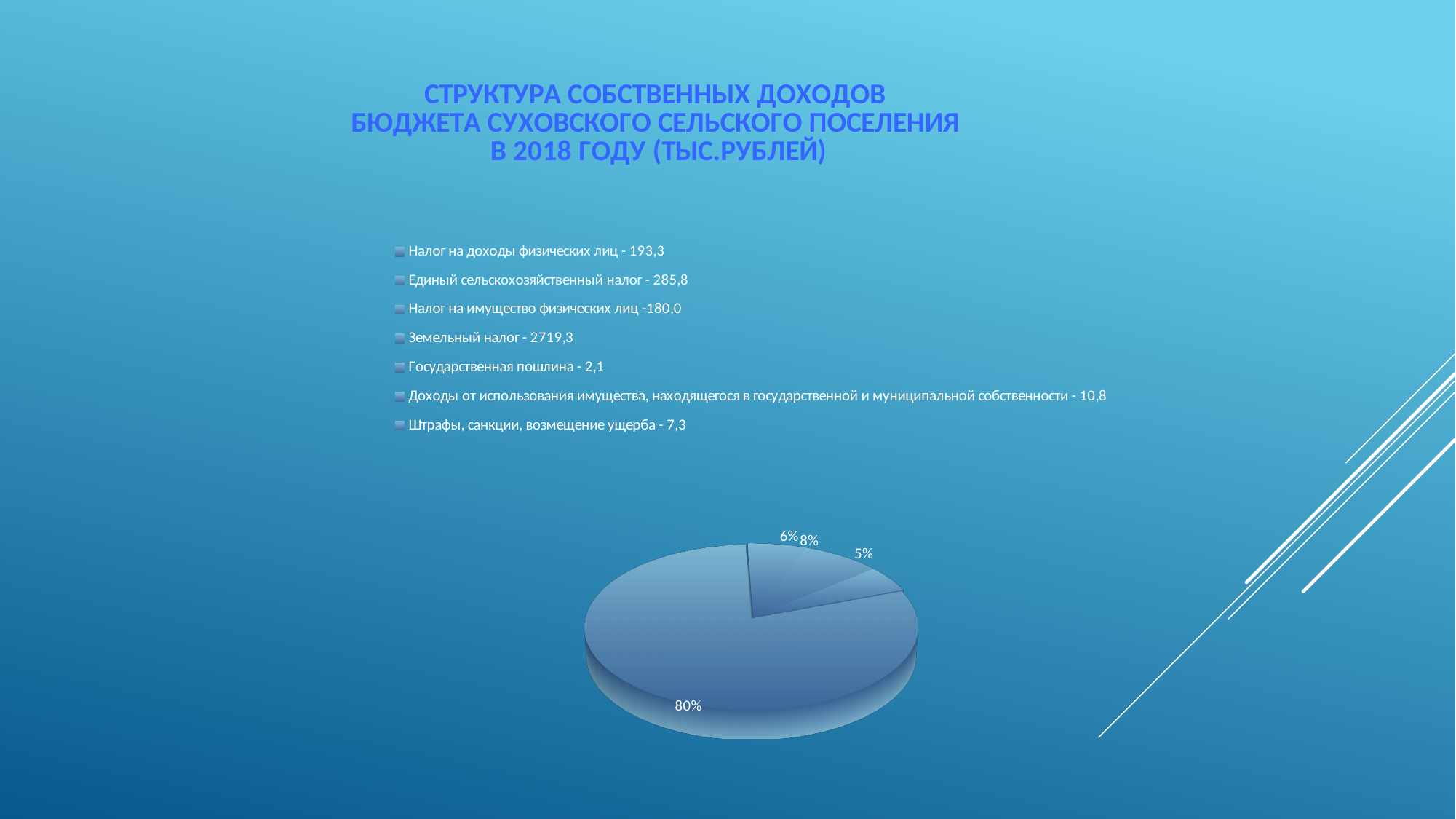
Which category has the lowest value according to the legend? Государственная пошлина What kind of chart is shown on the slide? pie chart How many percentage labels are printed on the pie chart? 4 What is the difference between the values for Единый сельскохозяйственный налог and Налог на доходы физических лиц? 92,5 What value is given in the legend for Земельный налог? 2719,3 Which is larger: Налог на имущество физических лиц or Налог на доходы физических лиц? Налог на доходы физических лиц How many entries does the chart legend list? 7 Which category has the highest value according to the legend? Земельный налог What value is given in the legend for Единый сельскохозяйственный налог? 285,8 What share of the pie does the largest slice (Земельный налог) represent? 80% What value is given in the legend for Государственная пошлина? 2,1 What is the difference between the values for Земельный налог and Единый сельскохозяйственный налог? 2433,5